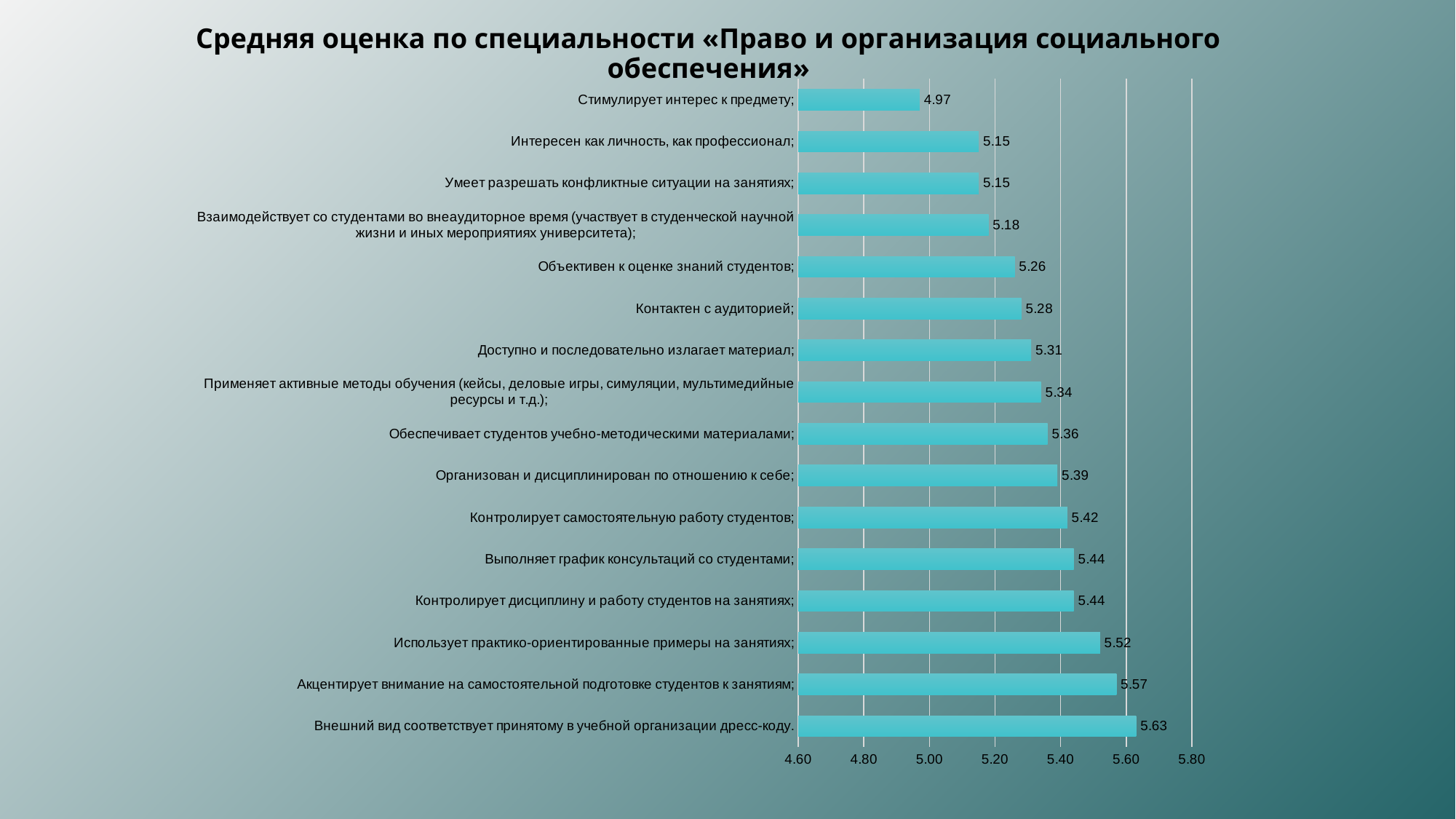
What is the average score for «Использует практико-ориентированные примеры на занятиях»? 5.52 Which category has the lowest average score? Стимулирует интерес к предмету What is the difference between the scores for «Использует практико-ориентированные примеры на занятиях» and «Объективен к оценке знаний студентов»? 0.26 Which has a higher score: «Контролирует самостоятельную работу студентов» or «Контактен с аудиторией»? Контролирует самостоятельную работу студентов What is the title of the chart? Средняя оценка по специальности «Право и организация социального обеспечения» Is the value for «Стимулирует интерес к предмету» greater or less than 5.00? less What is the average score for «Контактен с аудиторией»? 5.28 How many categories are shown in the chart? 16 What kind of chart is shown on the slide? bar chart What is the average score for «Стимулирует интерес к предмету»? 4.97 Which category has the highest average score? Внешний вид соответствует принятому в учебной организации дресс-коду What is the difference between the highest score (5.63) and the lowest score (4.97)? 0.66